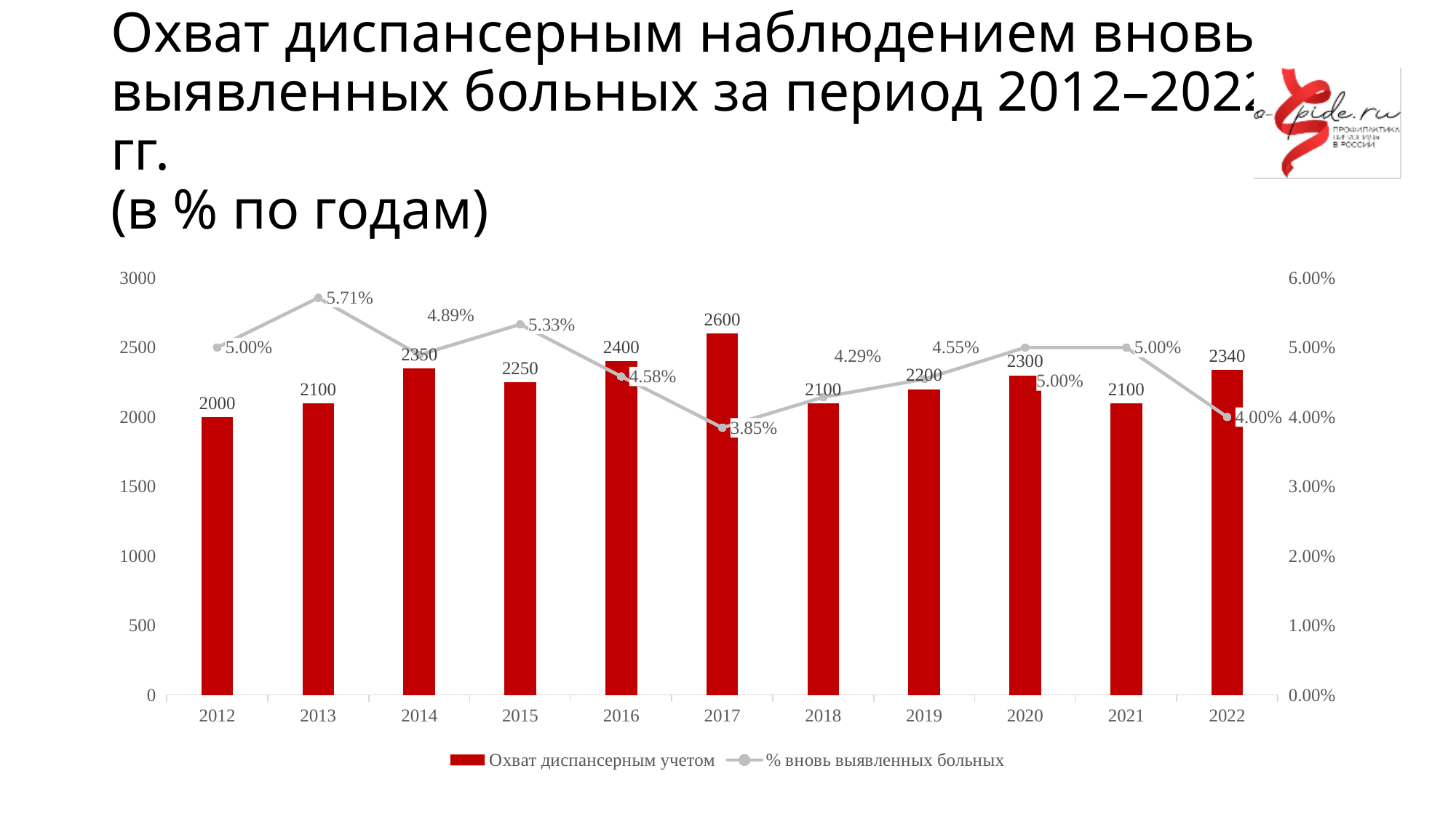
Which year has the lowest value of "% вновь выявленных больных"? 2017 Which year has the highest value of "Охват диспансерным учетом"? 2017 What is the value of "Охват диспансерным учетом" for 2017? 2600 What kind of chart is shown on the slide? Combined bar and line chart Which is larger: the "Охват диспансерным учетом" value for 2014 or for 2015? 2014 What is the difference between the "Охват диспансерным учетом" values for 2017 and 2012? 600 Does the "% вновь выявленных больных" line rise or fall from 2021 to 2022? Fall How many series does the legend list? 2 What is the value of "% вновь выявленных больных" for 2013? 5.71% What colour are the bars for "Охват диспансерным учетом"? Red What is the value of "Охват диспансерным учетом" for 2022? 2340 How many years are shown on the x axis? 11